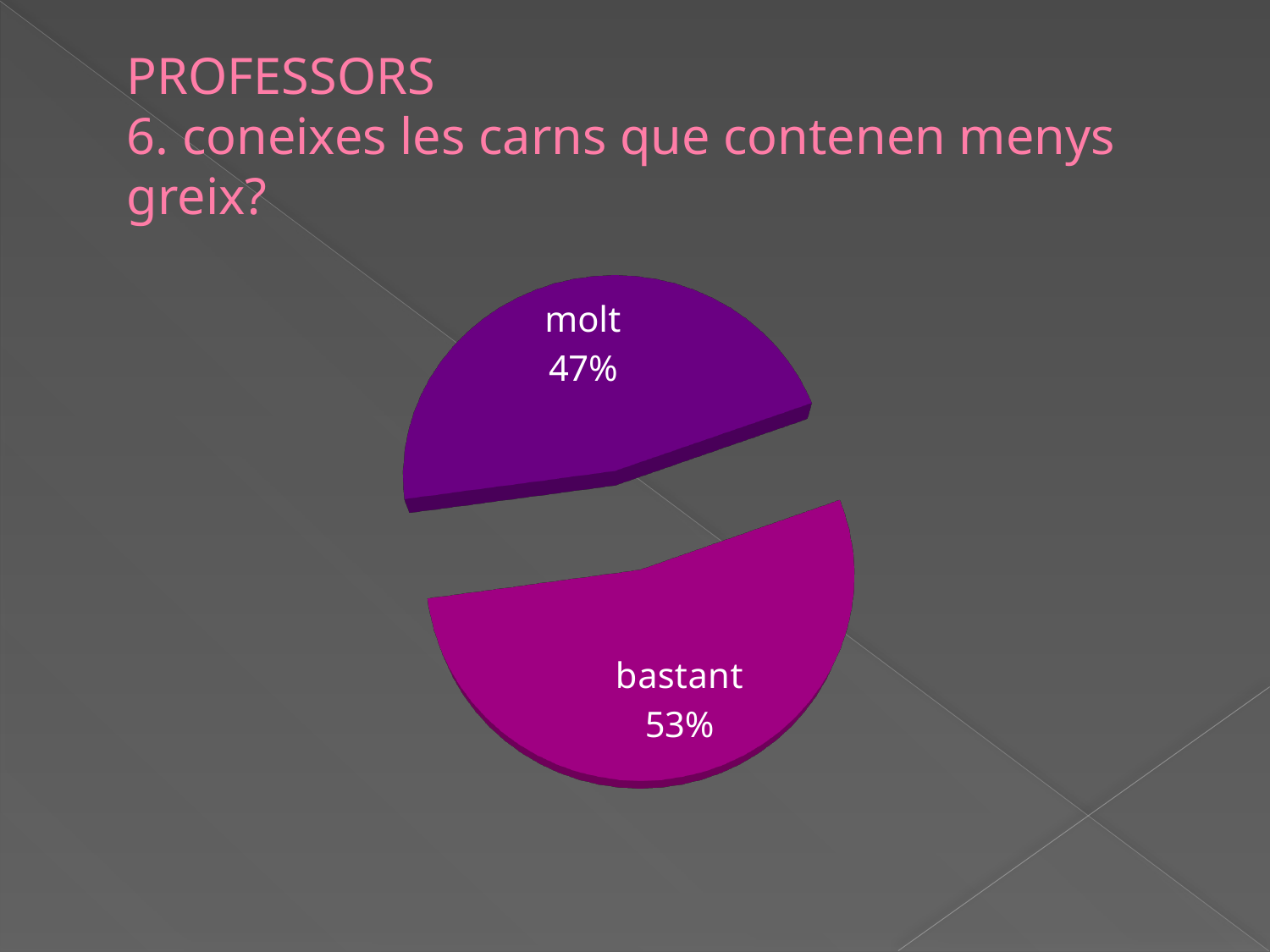
What is the difference in percentage points between the "bastant" and "molt" slices? 6 What percentage of the pie is labelled "molt"? 47% Which group of respondents does the slide title say the chart is about? PROFESSORS What percentage of the pie is labelled "bastant"? 53% Is the share for "bastant" greater or less than 50%? greater Which slice is larger, "molt" or "bastant"? bastant What is the total of the two slice percentages shown? 100% How many slices does the pie chart have? 2 Is the share for "molt" greater or less than 50%? less Which slice of the pie is the largest? bastant Which slice of the pie is the smallest? molt What kind of chart is shown on the slide? pie chart